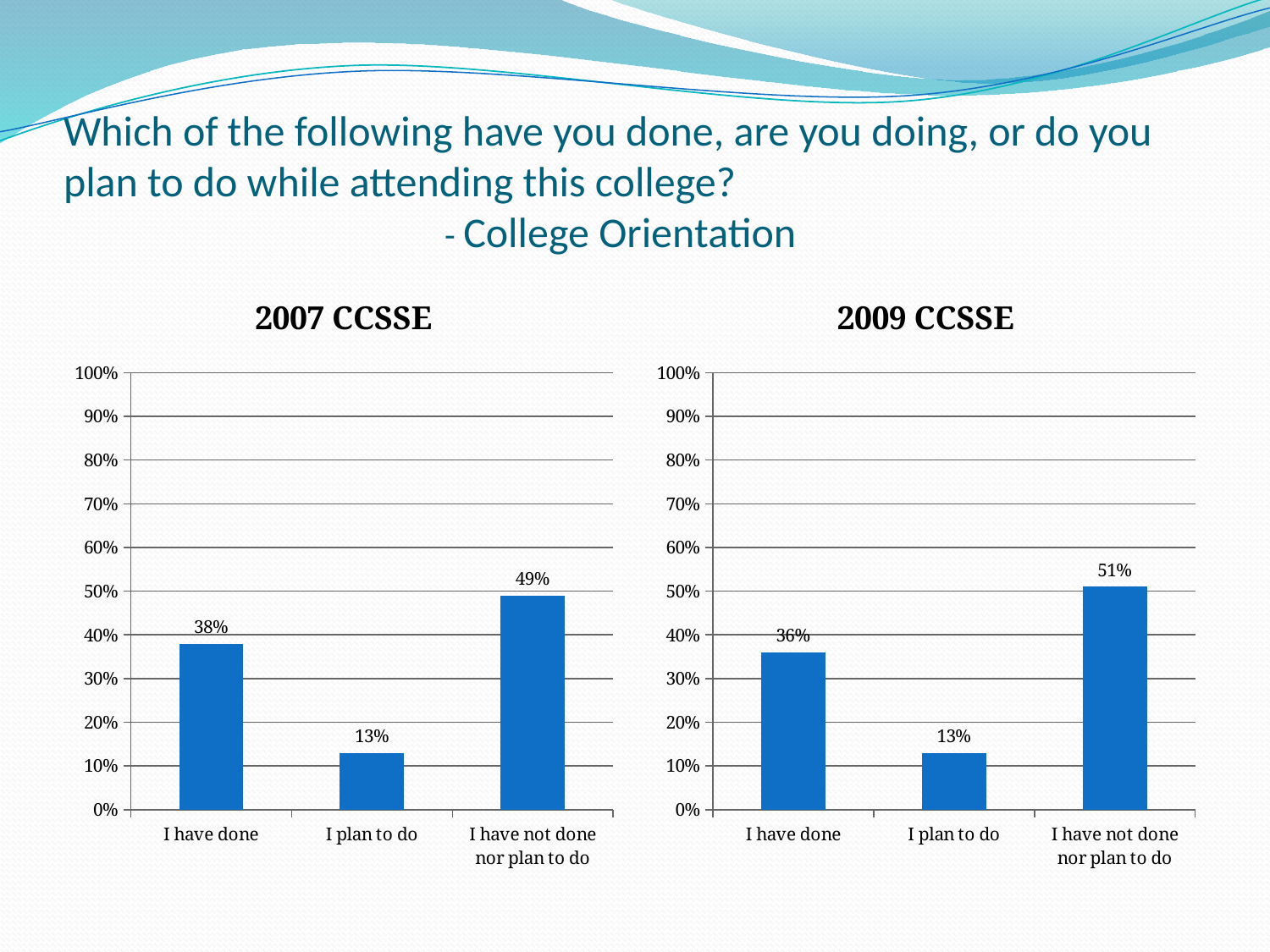
What is the title of the chart on the left side of the slide? 2007 CCSSE What is the difference between the "I have done" value in the 2007 CCSSE chart and the "I have done" value in the 2009 CCSSE chart? 2% Which is larger: "I have not done nor plan to do" in the 2007 CCSSE chart or in the 2009 CCSSE chart? 2009 CCSSE In the 2007 CCSSE chart, what is the difference between "I have not done nor plan to do" and "I have done"? 11% How many categories are shown in the 2007 CCSSE chart? 3 In the 2009 CCSSE chart, which category has the lowest value? I plan to do In the 2007 CCSSE chart, what is the value for "I have done"? 38% In the 2009 CCSSE chart, what is the value for "I plan to do"? 13% What kind of chart is the 2009 CCSSE chart? bar chart In the 2009 CCSSE chart, is the value for "I have done" greater or less than 40%? less In the 2009 CCSSE chart, what is the value for "I have not done nor plan to do"? 51% In the 2007 CCSSE chart, which category has the highest value? I have not done nor plan to do